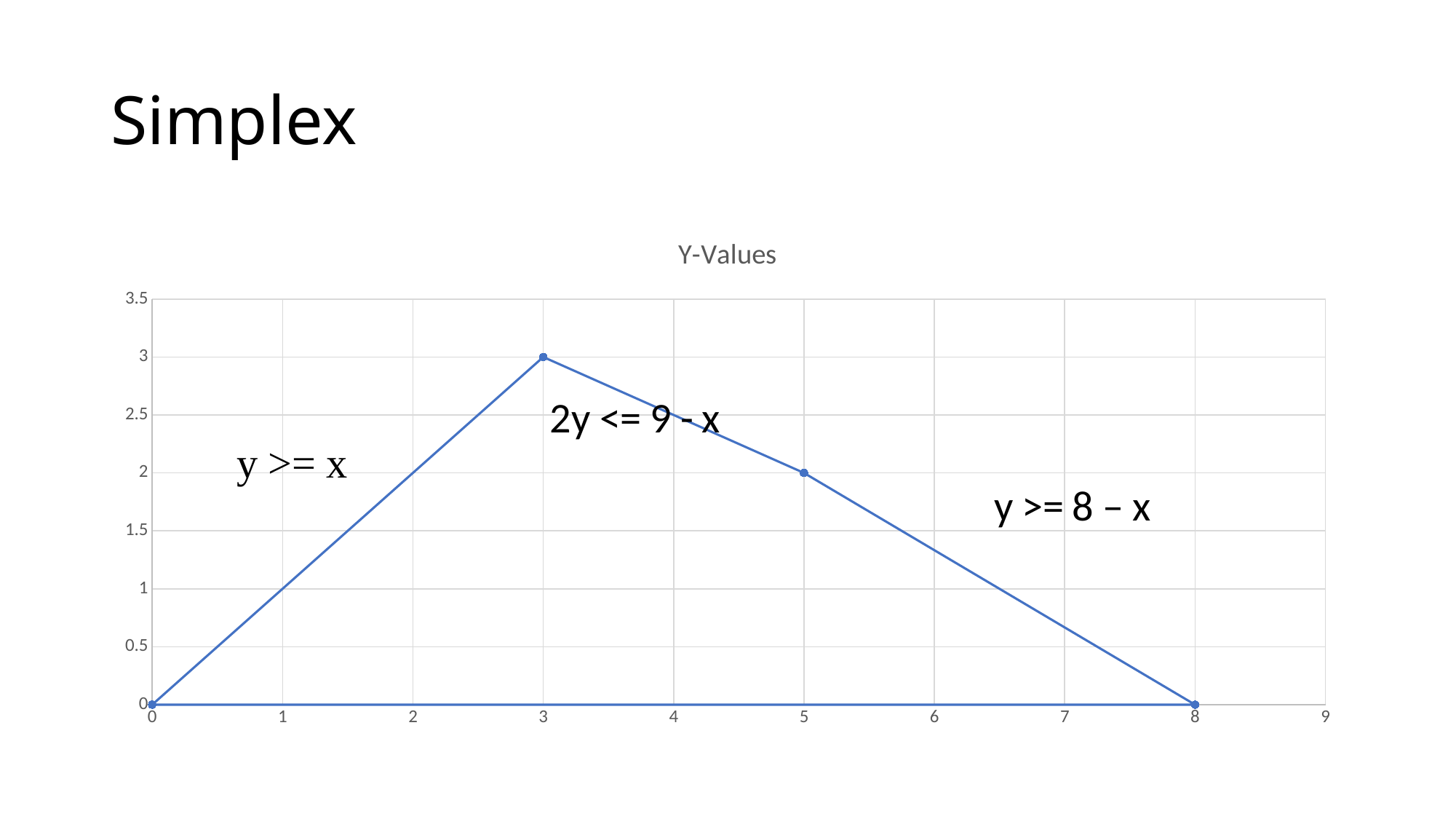
What is the y value of the point at x = 5? 2 How many data points are marked on the chart? 4 Is the y value at x = 5 greater or less than 2.5? less What is the y value of the point at x = 3? 3 What kind of chart is shown on the slide? line chart At which x value does the plotted line reach its highest y value? 3 What is the y value of the point at x = 8? 0 Which has the larger y value, the point at x = 3 or the point at x = 5? x = 3 What is the difference between the y values at x = 3 and x = 5? 1 What is the highest value shown on the y axis? 3.5 Does the line rise or fall between x = 3 and x = 8? fall What is the title of the chart? Y-Values